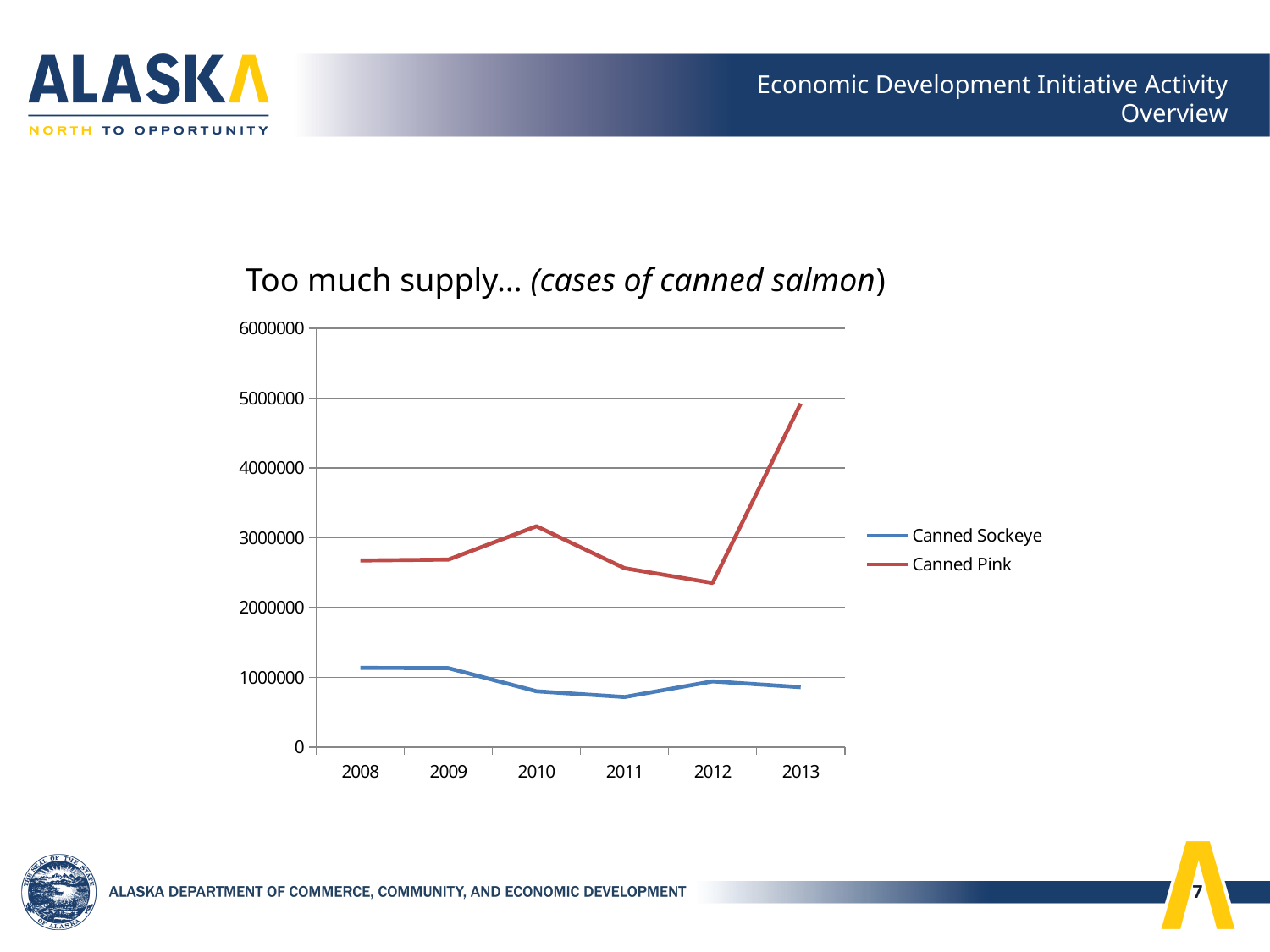
How many years are plotted along the x axis? 6 Is the value for Canned Sockeye in 2011 greater or less than 1000000? less Is the value for Canned Pink in 2010 greater or less than 3000000? greater In which year is the Canned Pink value lowest? 2012 In which year is the Canned Pink value highest? 2013 Is the value for Canned Pink in 2013 greater or less than 4000000? greater Which colour is used for the Canned Sockeye line? Blue Does the Canned Pink line rise or fall from 2012 to 2013? Rises What kind of chart is shown on the slide? Line chart How many series does the legend list? 2 Which series has the larger value in 2013, Canned Sockeye or Canned Pink? Canned Pink